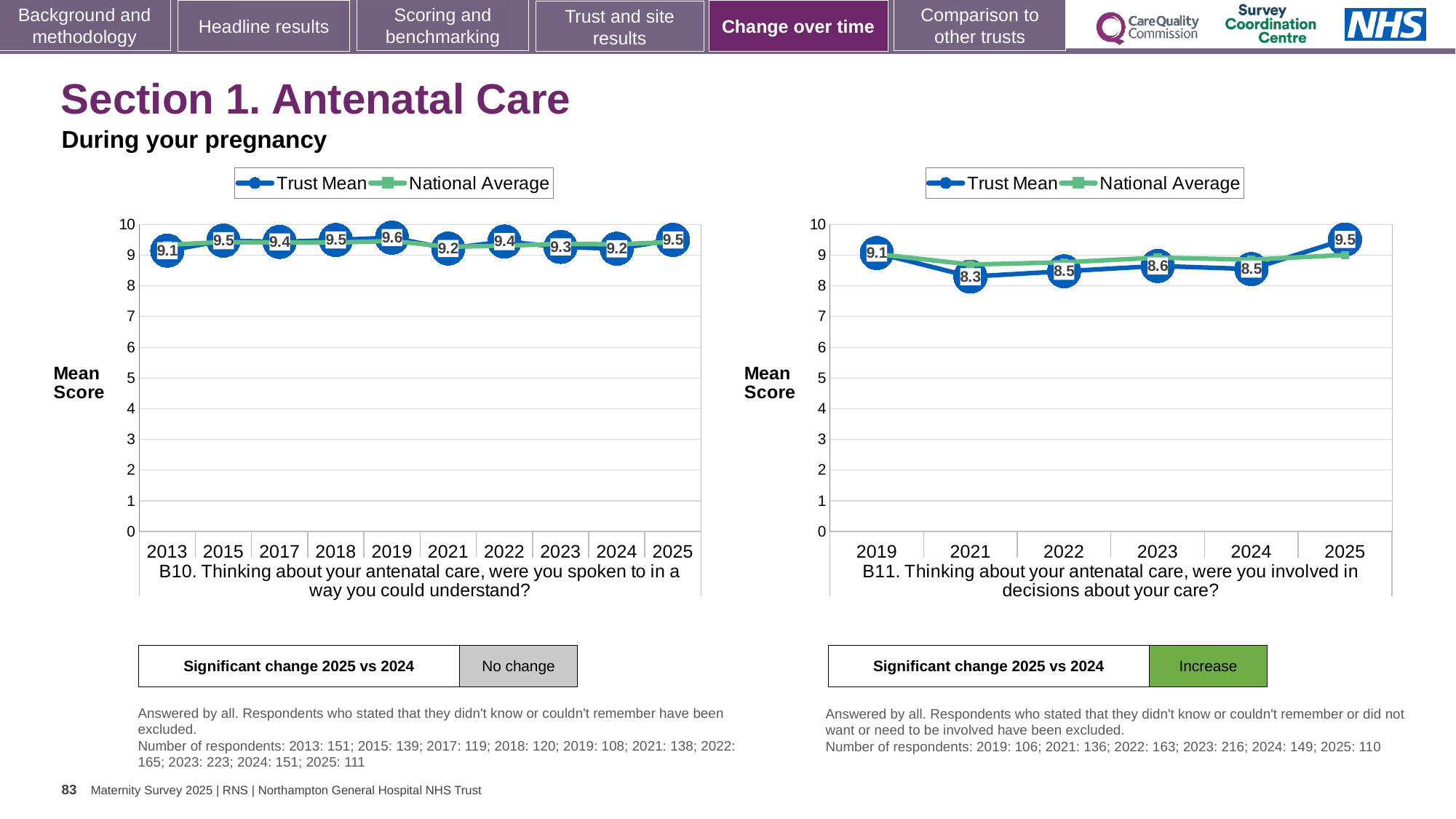
On the B11 chart (right), how many series does the legend list? 2 On the B11 chart (right), what is the Trust Mean score for 2021? 8.3 On the B11 chart (right), is the Trust Mean score for 2023 or 2024 larger? 2023 On the B10 chart (left), what is the Trust Mean score for 2013? 9.1 What kind of chart is the B11 chart (right)? Line chart On the B10 chart (left), what is the Trust Mean score for 2019? 9.6 On the B11 chart (right), which year has the lowest Trust Mean score? 2021 On the B10 chart (left), how many years are shown on the x axis? 10 On the B11 chart (right), what is the Trust Mean score for 2025? 9.5 On the B10 chart (left), which year has the lowest Trust Mean score? 2013 On the B10 chart (left), which year has the highest Trust Mean score? 2019 On the B10 chart (left), what is the difference between the Trust Mean scores for 2025 and 2024? 0.3